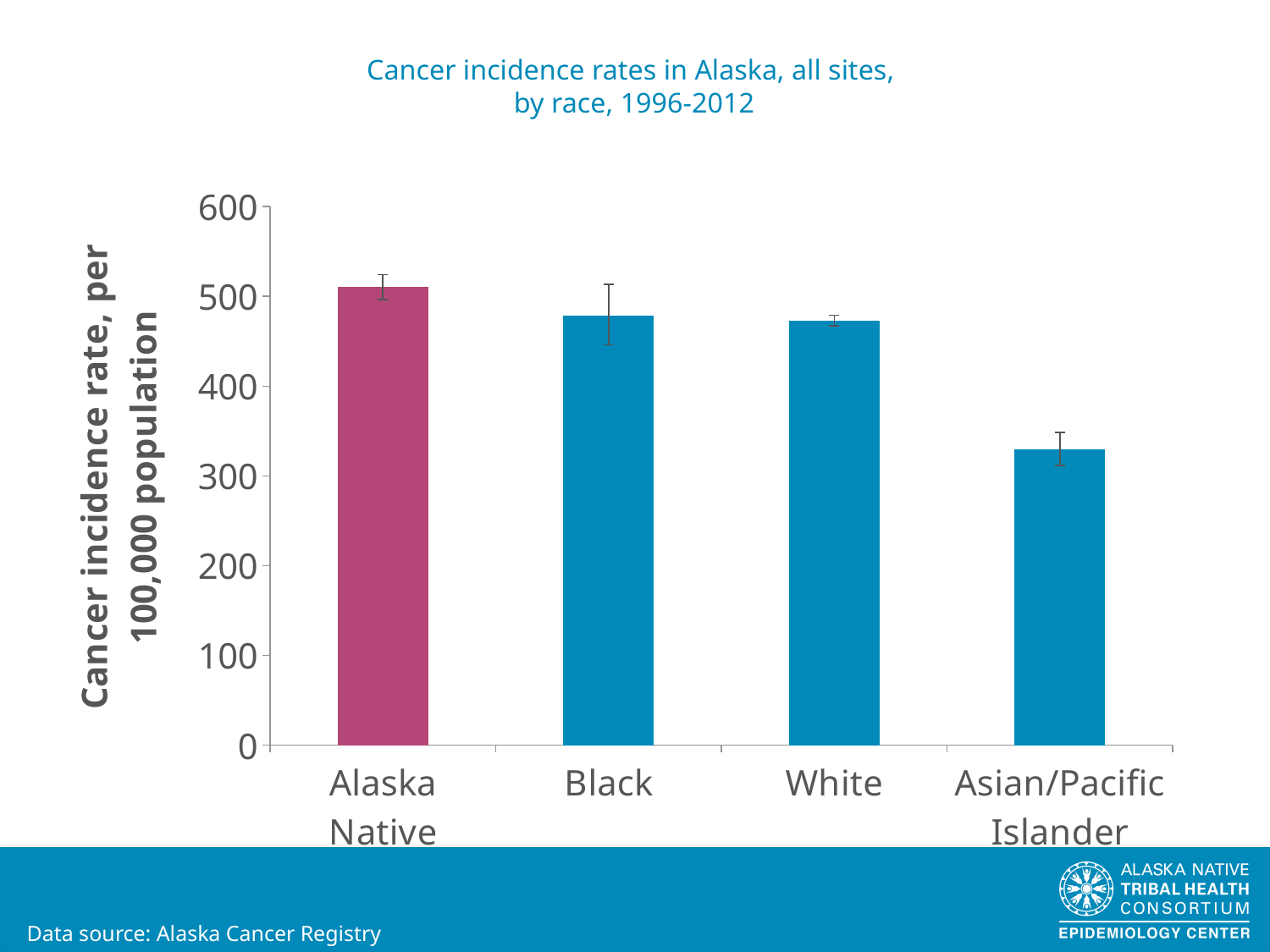
Is the cancer incidence rate for Black greater or less than 500? less Is the cancer incidence rate for White greater or less than 400? greater What kind of chart is shown on the slide? Bar chart How many race categories are plotted on the chart? 4 Is the cancer incidence rate for Asian/Pacific Islander greater or less than 300? greater Which race category has the highest cancer incidence rate? Alaska Native What is the title of the chart? Cancer incidence rates in Alaska, all sites, by race, 1996-2012 Which race category has the lowest cancer incidence rate? Asian/Pacific Islander Which has a higher cancer incidence rate, Alaska Native or Asian/Pacific Islander? Alaska Native Which bar is shown in a different colour from the others? Alaska Native